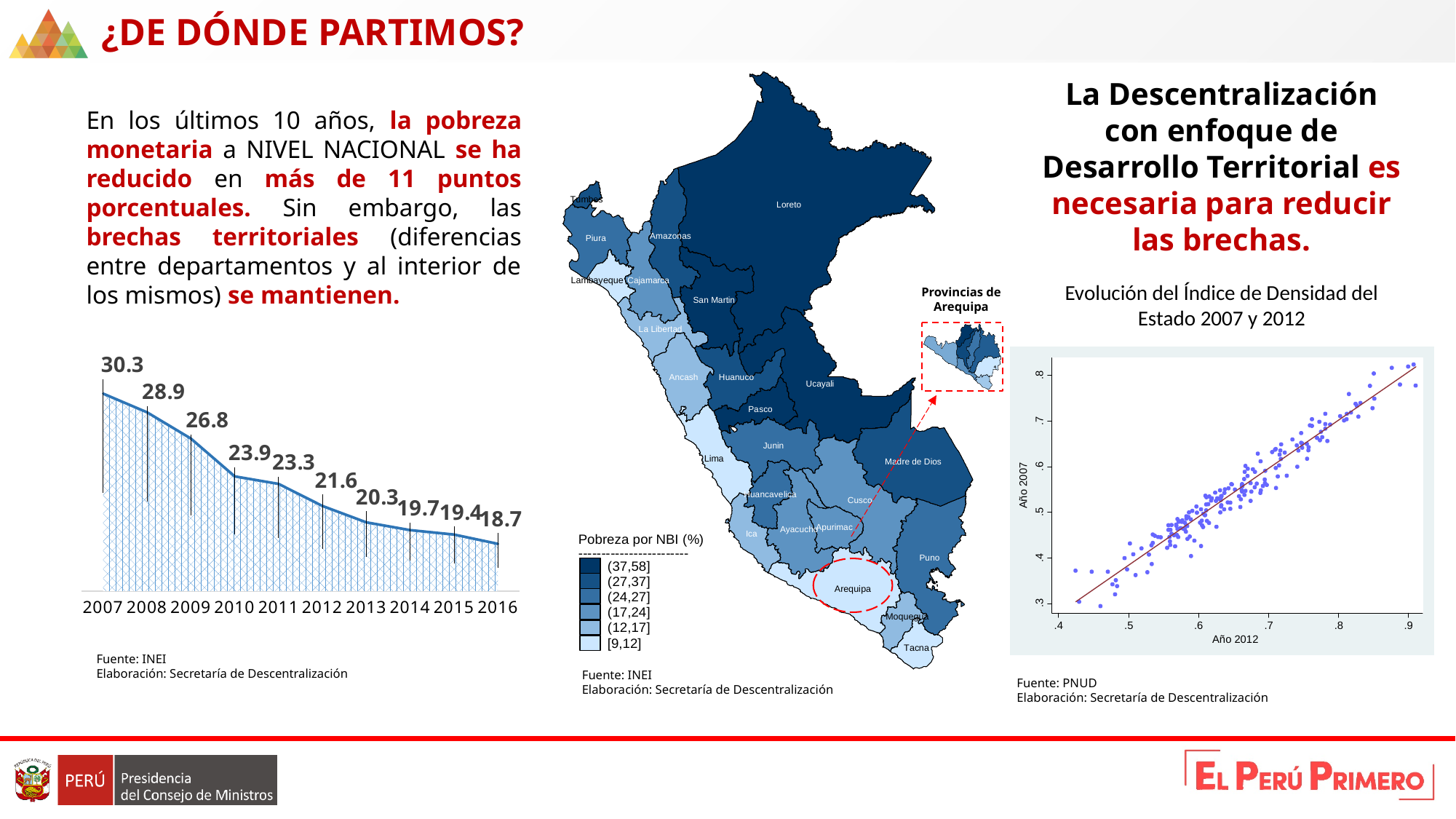
In the line chart on the left of the slide, what is the difference between the values for 2007 and 2016? 11.6 In the line chart on the left of the slide, do the values rise or fall from 2007 to 2016? fall In the line chart on the left of the slide, which year has the lowest value? 2016 In the line chart on the left of the slide, how many years are plotted? 10 In the line chart on the left of the slide, which is larger, the value for 2010 or the value for 2011? 2010 In the scatter plot on the right of the slide, what is the label of the horizontal axis? Año 2012 What kind of chart is shown on the left of the slide, below the text? line chart In the line chart on the left of the slide, what is the value for 2016? 18.7 In the line chart on the left of the slide, what is the value for 2007? 30.3 In the line chart on the left of the slide, which year has the highest value? 2007 In the line chart on the left of the slide, what is the value for 2012? 21.6 What kind of chart is shown on the right of the slide, titled 'Evolución del Índice de Densidad del Estado 2007 y 2012'? scatter plot